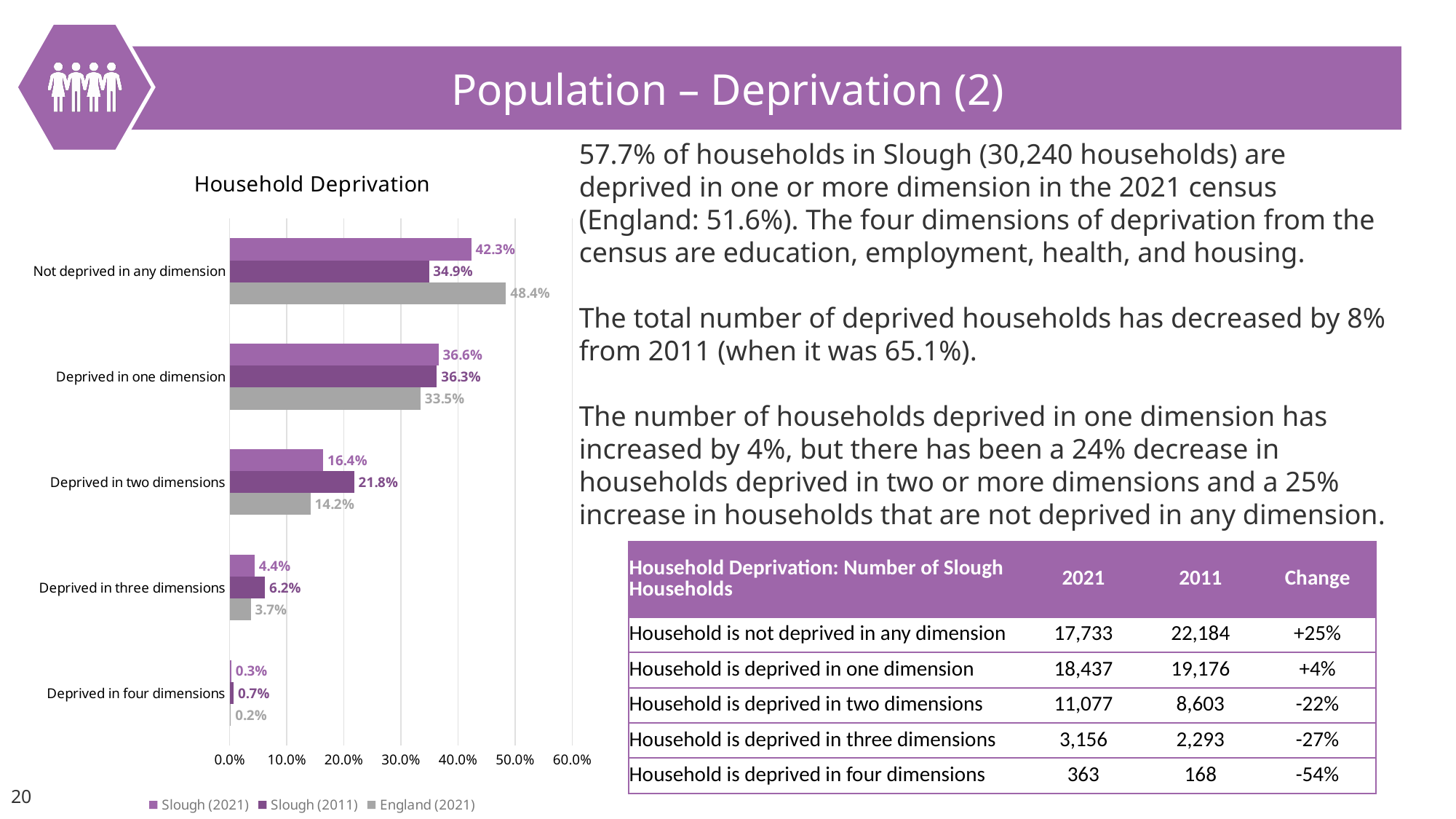
What kind of chart is shown on the slide? Bar chart What is the difference between the Slough (2021) and Slough (2011) values for 'Deprived in two dimensions'? 5.4% For 'Not deprived in any dimension', which is larger: the Slough (2021) value or the England (2021) value? England (2021) Which category has the highest England (2021) value? Not deprived in any dimension What is the title of the chart? Household Deprivation What is the England (2021) value for 'Deprived in two dimensions'? 14.2% Is the Slough (2011) value for 'Deprived in one dimension' greater or less than 30.0%? greater Which category has the lowest Slough (2021) value? Deprived in four dimensions What is the Slough (2021) value for 'Not deprived in any dimension'? 42.3% How many categories are shown on the chart? 5 What is the Slough (2011) value for 'Deprived in three dimensions'? 6.2% How many series does the legend list? 3